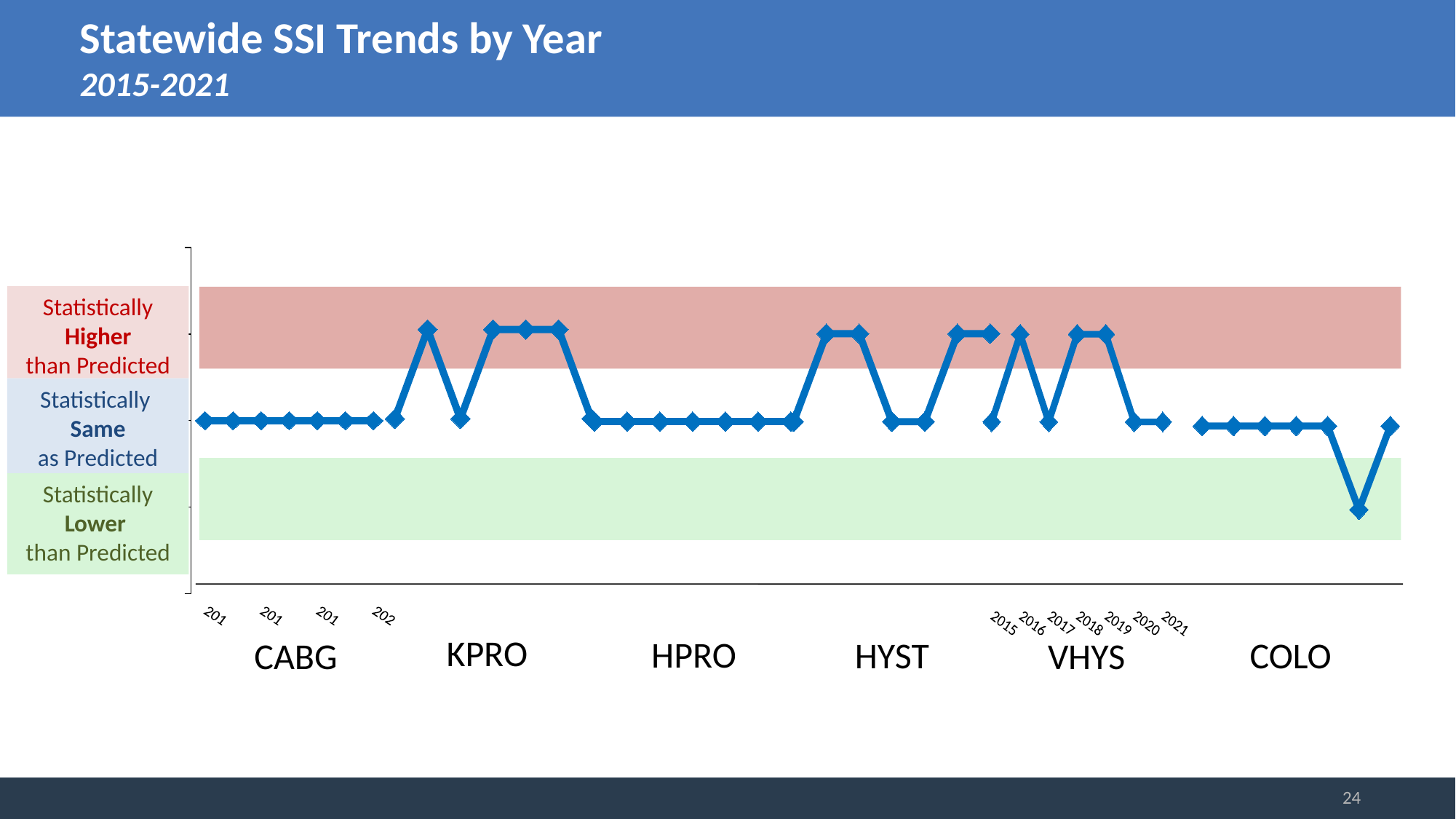
What range of years does the chart cover, according to the subtitle? 2015-2021 What kind of chart is shown on the slide? line chart What colour is the plotted line? blue How many procedure categories are labelled along the x axis? 6 Does COLO have any point in the 'Statistically Higher than Predicted' band? No How many yearly points are plotted for VHYS? 7 In which band do all of the HPRO points fall? Statistically Same as Predicted In which band does the final (2021) point for COLO fall? Statistically Same as Predicted Which procedure's points are listed first on the x axis? CABG Which procedure has a point that falls in the 'Statistically Lower than Predicted' band? COLO In which band do all of the CABG points fall? Statistically Same as Predicted Which procedures have at least one point in the 'Statistically Higher than Predicted' band? KPRO, HYST, VHYS